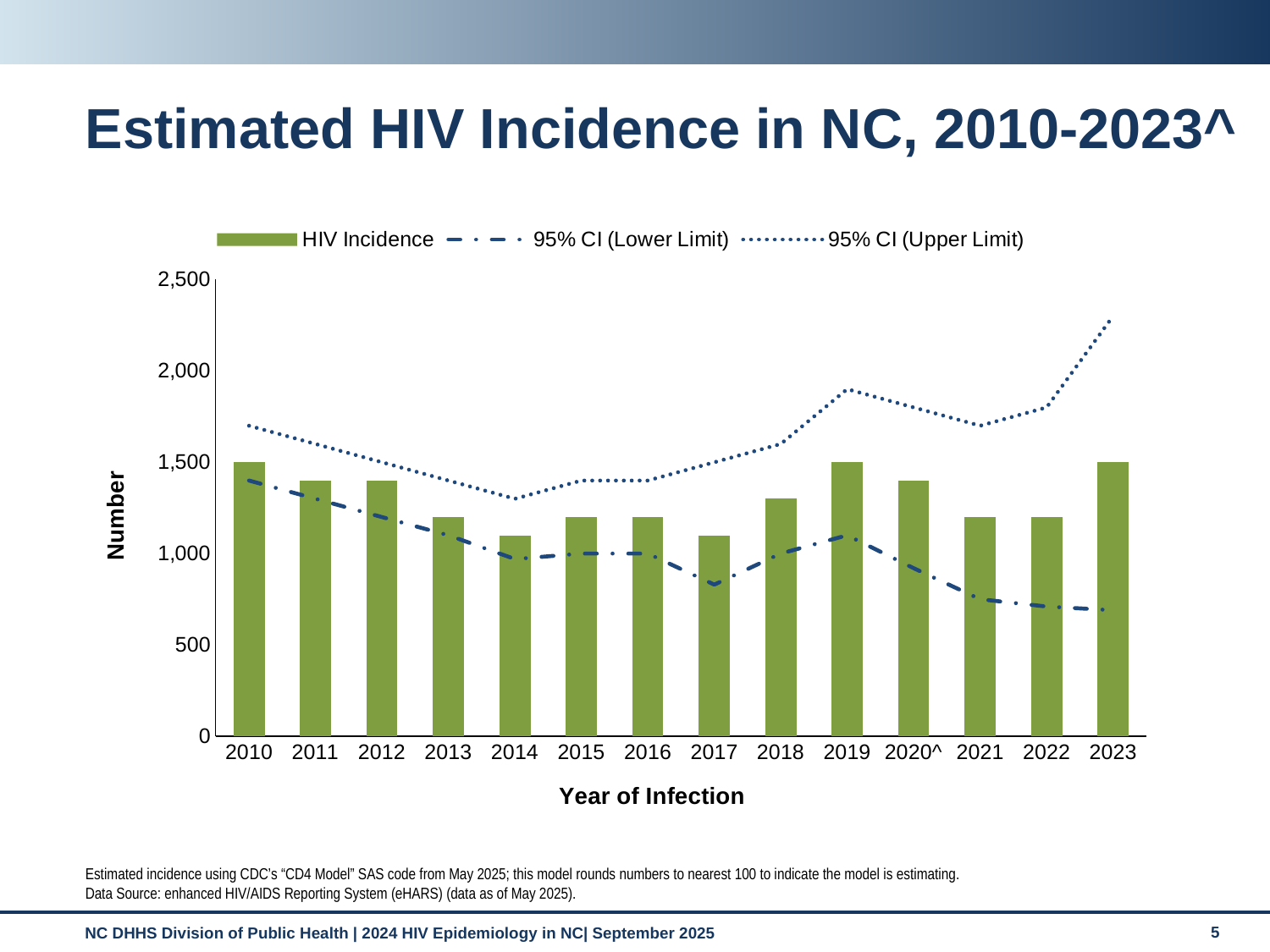
Is the 95% CI (Upper Limit) value for 2023 greater or less than 2,000? greater Which year has the higher HIV Incidence, 2017 or 2018? 2018 How many years are shown on the x axis of the chart? 14 Is the 95% CI (Lower Limit) value for 2022 greater or less than 1,000? less Is the HIV Incidence value for 2017 greater or less than 1,000? greater Which year has the higher HIV Incidence, 2010 or 2014? 2010 What is the HIV Incidence value for 2023? 1,500 What is the label of the x axis? Year of Infection What is the HIV Incidence value for 2010? 1,500 What kind of chart is used to show HIV Incidence on this slide? bar chart How many series does the chart legend list? 3